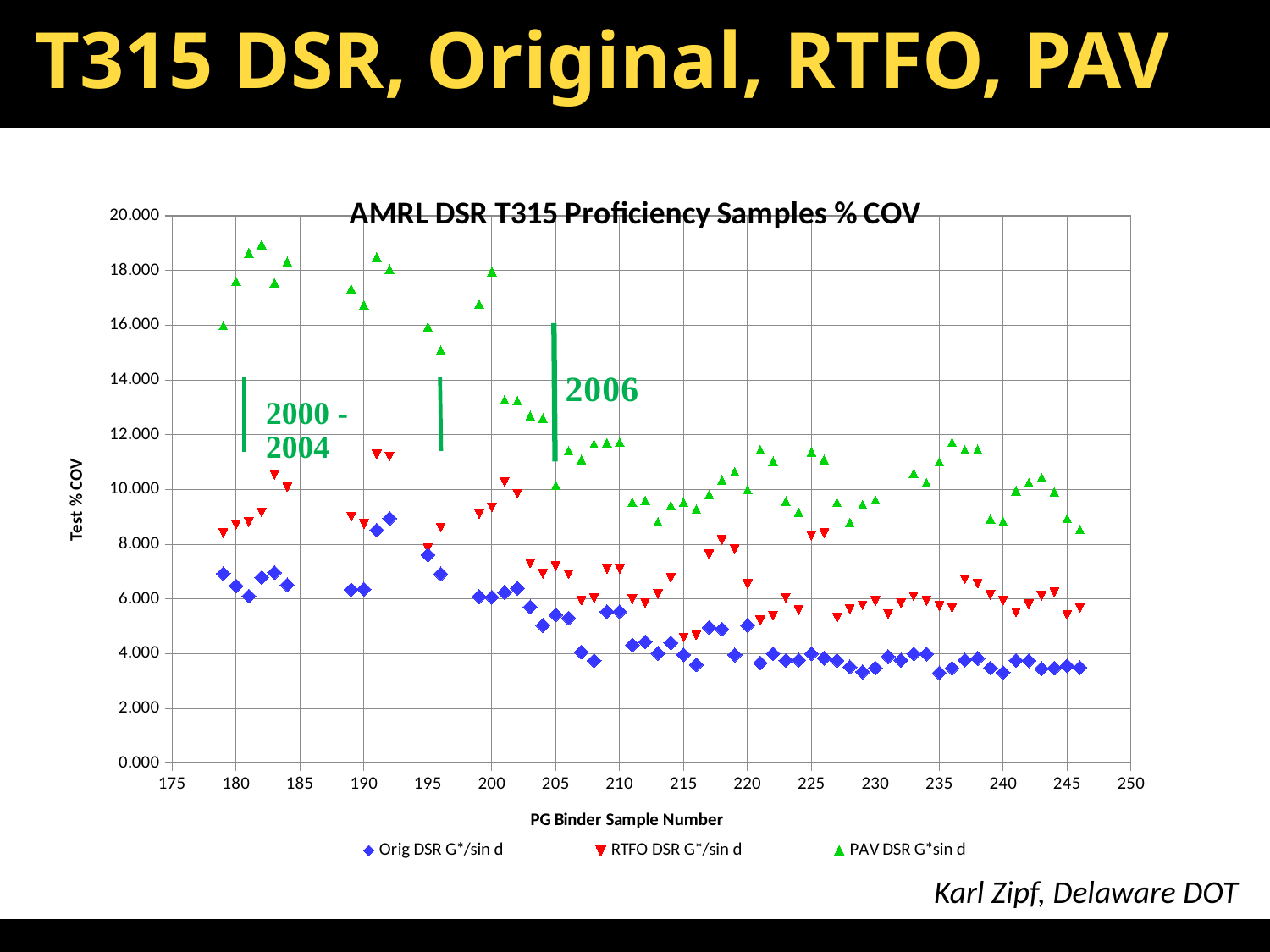
Which series generally has the highest values across the chart? PAV DSR G*sin d Is the Orig DSR G*/sin d value at sample 246 greater or less than 4.000? less Is the RTFO DSR G*/sin d value at sample 183 greater or less than 8.000? greater What kind of chart is shown on the slide? scatter chart What is the title of the chart? AMRL DSR T315 Proficiency Samples % COV At sample 179, which is larger: the PAV DSR G*sin d value or the Orig DSR G*/sin d value? PAV DSR G*sin d What is the label of the vertical axis? Test % COV Is the PAV DSR G*sin d value at sample 182 greater or less than 18.000? greater Do the PAV DSR G*sin d values generally rise or fall as the PG Binder Sample Number increases? fall How many series does the legend list? 3 Which series generally has the lowest values across the chart? Orig DSR G*/sin d